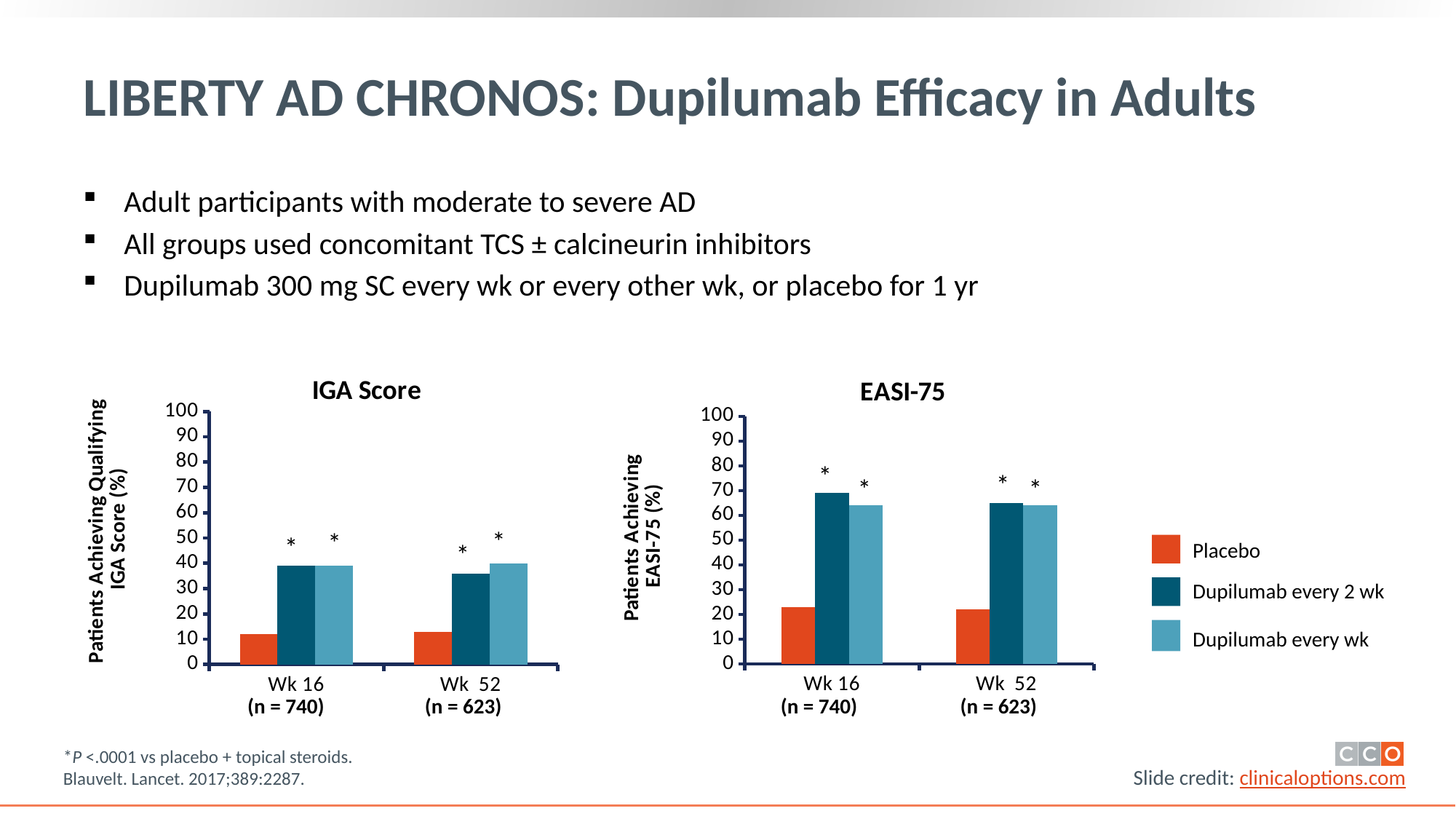
In the EASI-75 chart at Wk 16, which is larger: Placebo or Dupilumab every 2 wk? Dupilumab every 2 wk In the EASI-75 chart, is the value for Dupilumab every wk at Wk 52 greater or less than 50? greater In the IGA Score chart, is the value for Placebo at Wk 16 greater or less than 20? less In the IGA Score chart, is the value for Dupilumab every 2 wk at Wk 16 greater or less than 30? greater Which series is shown in orange in the legend? Placebo What is the title of the chart on the right side of the slide? EASI-75 How many time-point categories are shown on the x axis of the EASI-75 chart? 2 In the IGA Score chart at Wk 52, which series has the lowest value? Placebo What kind of chart is the IGA Score chart? bar chart How many series does the legend list for the charts? 3